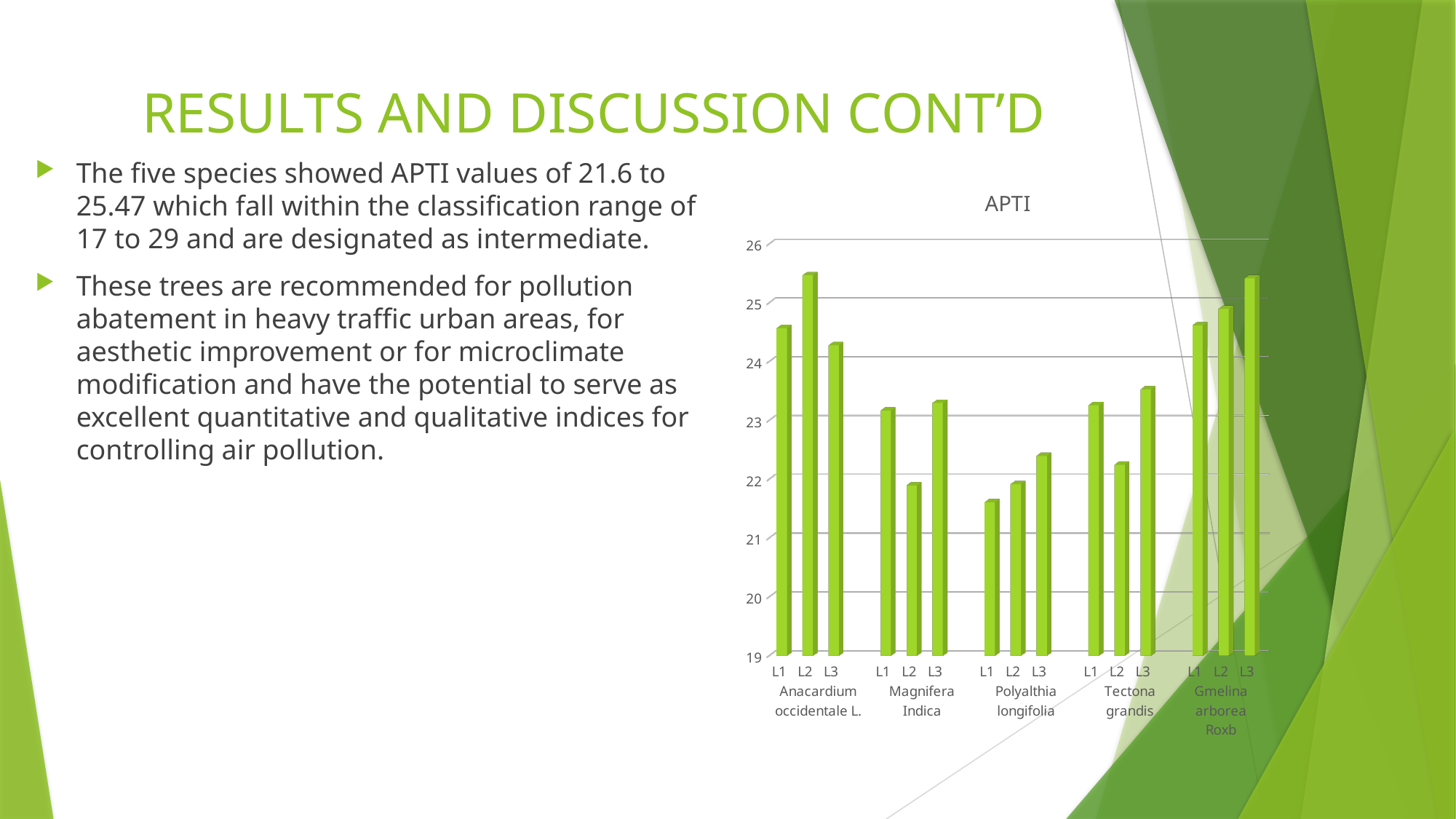
What is the title of the chart? APTI Which location has the highest APTI value for Anacardium occidentale L.? L2 Is the APTI value for L3 of Tectona grandis greater or less than 23? greater Is the APTI value for L2 of Anacardium occidentale L. greater or less than 25? greater What kind of chart is shown on the slide? bar chart Is the APTI value for L3 of Gmelina arborea Roxb greater or less than 25? greater How many tree species are shown on the x axis of the chart? 5 How many bars are plotted in the chart in total? 15 Which is larger, the APTI value for L1 of Anacardium occidentale L. or L1 of Magnifera Indica? L1 of Anacardium occidentale L. Which location has the lowest APTI value for Magnifera Indica? L2